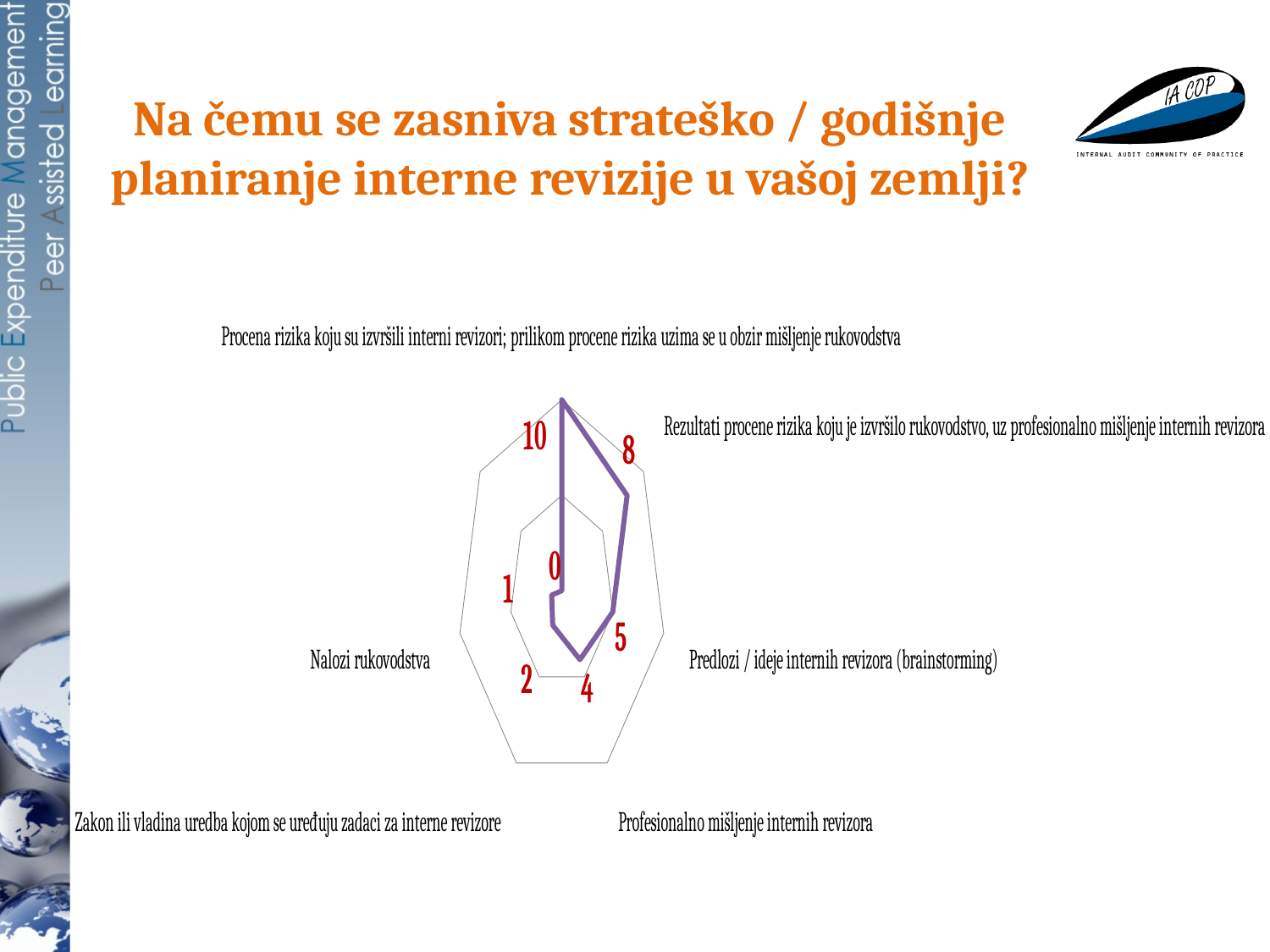
What type of chart is shown on the slide? Radar chart What is the value for 'Nalozi rukovodstva'? 1 What is the value for 'Rezultati procene rizika koju je izvršilo rukovodstvo, uz profesionalno mišljenje internih revizora'? 8 What is the value for 'Zakon ili vladina uredba kojom se uređuju zadaci za interne revizore'? 2 Which has a larger value: 'Predlozi / ideje internih revizora (brainstorming)' or 'Profesionalno mišljenje internih revizora'? Predlozi / ideje internih revizora (brainstorming) How many axes (categories) does the radar chart have? 7 Which has a larger value: 'Zakon ili vladina uredba kojom se uređuju zadaci za interne revizore' or 'Nalozi rukovodstva'? Zakon ili vladina uredba kojom se uređuju zadaci za interne revizore What is the lowest value plotted on the chart? 0 What is the difference between the values for 'Rezultati procene rizika koju je izvršilo rukovodstvo...' and 'Predlozi / ideje internih revizora (brainstorming)'? 3 What is the highest value plotted on the chart? 10 What is the value for 'Profesionalno mišljenje internih revizora'? 4 What is the value for 'Predlozi / ideje internih revizora (brainstorming)'? 5